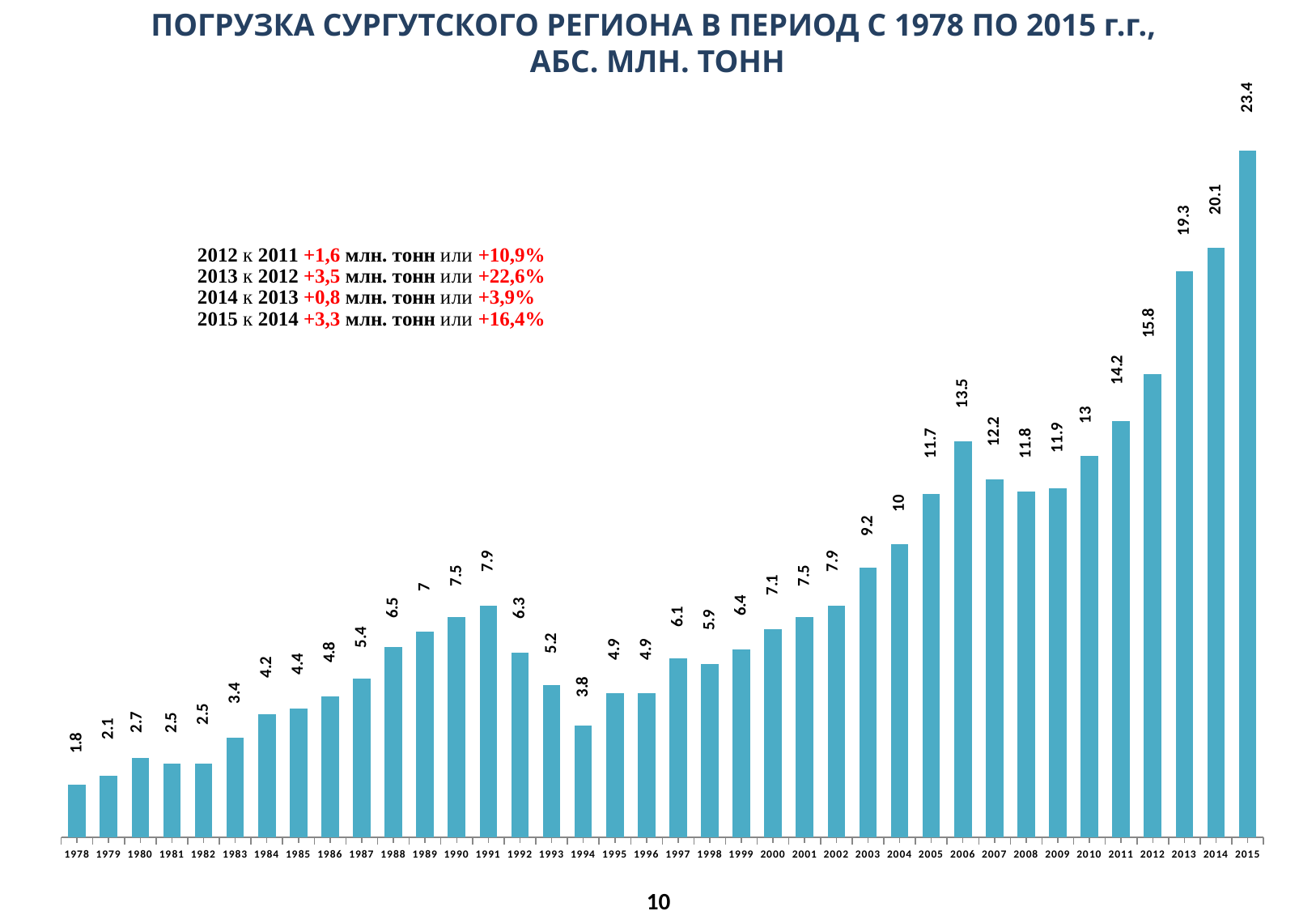
What is the difference between the values for 2006 and 2007? 1.3 Which year has the highest value? 2015 Which is larger, the value for 1991 or the value for 2002? They are equal (7.9) What is the difference between the values for 2015 and 2014? 3.3 What is the value for 2015? 23.4 How many years are shown on the x axis? 38 What is the value for 1978? 1.8 What is the value for 1994? 3.8 Which year has the lowest value? 1978 Which is larger, the value for 2008 or the value for 2010? 2010 What is the value for 2006? 13.5 What kind of chart is this? Bar chart